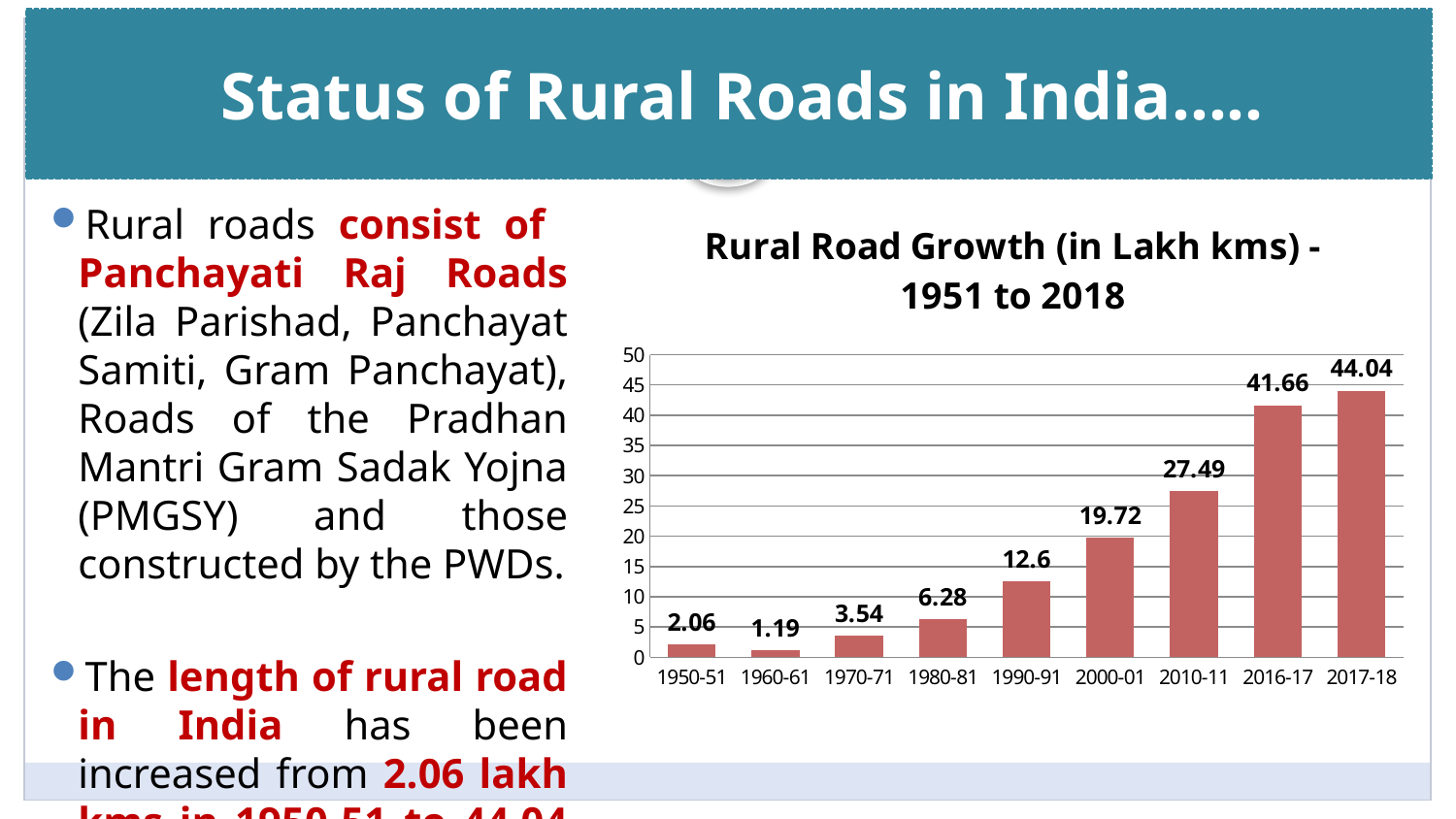
What is the title of the chart? Rural Road Growth (in Lakh kms) - 1951 to 2018 What is the difference between the values for 2000-01 and 1980-81? 13.44 What is the value for 1950-51 in the Rural Road Growth chart? 2.06 Which year has the lowest value in the Rural Road Growth chart? 1960-61 What is the value for 1990-91 in the Rural Road Growth chart? 12.6 Is the value for 2010-11 greater or less than 25? greater What is the difference between the values for 2017-18 and 2016-17? 2.38 How many years are shown on the x axis of the chart? 9 Which is larger, the value for 1950-51 or the value for 1960-61? 1950-51 What is the value for 2010-11 in the Rural Road Growth chart? 27.49 Which year has the highest value in the Rural Road Growth chart? 2017-18 What kind of chart is shown on the slide? bar chart